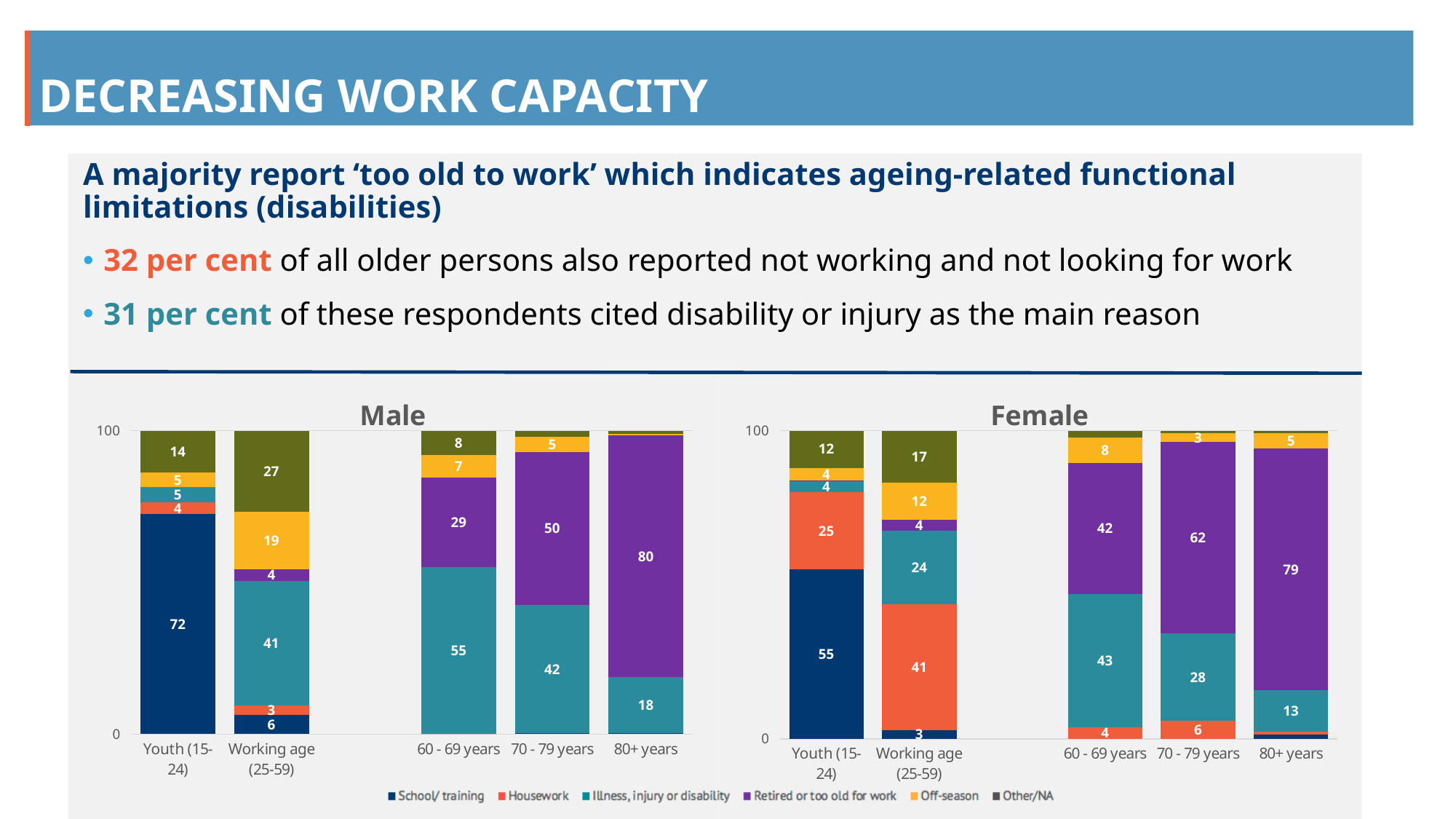
In the Male chart, what is the value for 'School/ training' in the Youth (15-24) category? 72 In the Female chart, which is larger: 'Retired or too old for work' for 70 - 79 years or for 60 - 69 years? 70 - 79 years How many series does the legend list? 6 In the Male chart, what is the difference between the 'Illness, injury or disability' values for 60 - 69 years and 80+ years? 37 In the Female chart, what is the value for 'Illness, injury or disability' in the 60 - 69 years category? 43 In the Female chart, what is the value for 'Housework' in the Working age (25-59) category? 41 In the Male chart, which age category has the highest value for 'Retired or too old for work'? 80+ years In the Female chart, does the value for 'Retired or too old for work' rise or fall from 60 - 69 years to 80+ years? Rise In the Male chart, what is the value for 'Retired or too old for work' in the 80+ years category? 80 In the Female chart, which age category has the lowest value for 'Illness, injury or disability'? Youth (15-24) What kind of chart is the Male chart? Stacked bar chart How many age categories are shown in the Female chart? 5